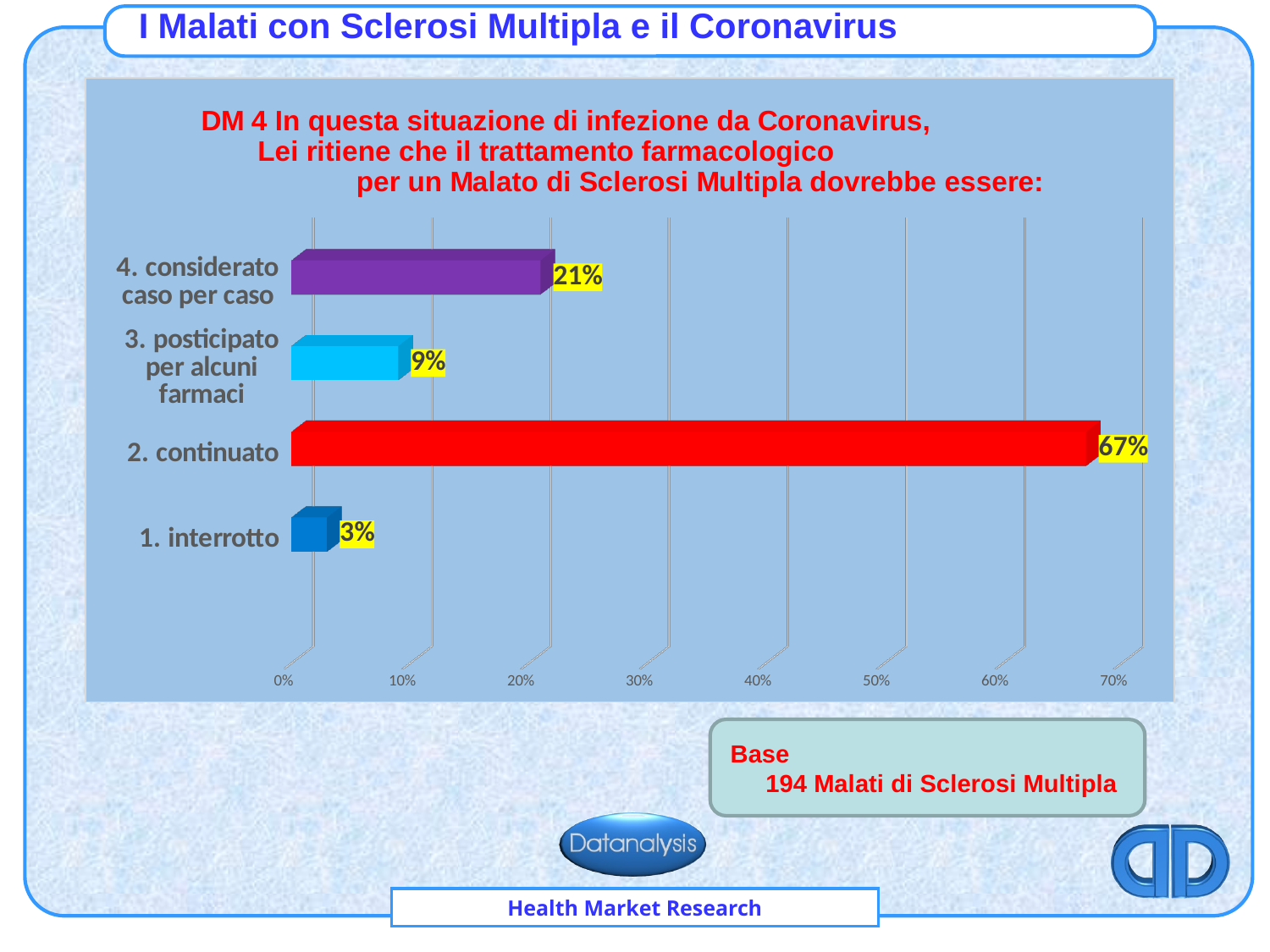
What is the value for "1. interrotto"? 3% What is the value for "2. continuato"? 67% What kind of chart is shown on the slide? bar chart Which category has the highest value? 2. continuato How many categories are shown in the chart? 4 Is the value for "2. continuato" greater or less than 60%? greater Which category has the lowest value? 1. interrotto Which is larger, the value for "3. posticipato per alcuni farmaci" or the value for "4. considerato caso per caso"? 4. considerato caso per caso What is the value for "4. considerato caso per caso"? 21% What colour is the bar for "2. continuato"? red What is the difference between the values for "2. continuato" and "4. considerato caso per caso"? 46% What is the value for "3. posticipato per alcuni farmaci"? 9%